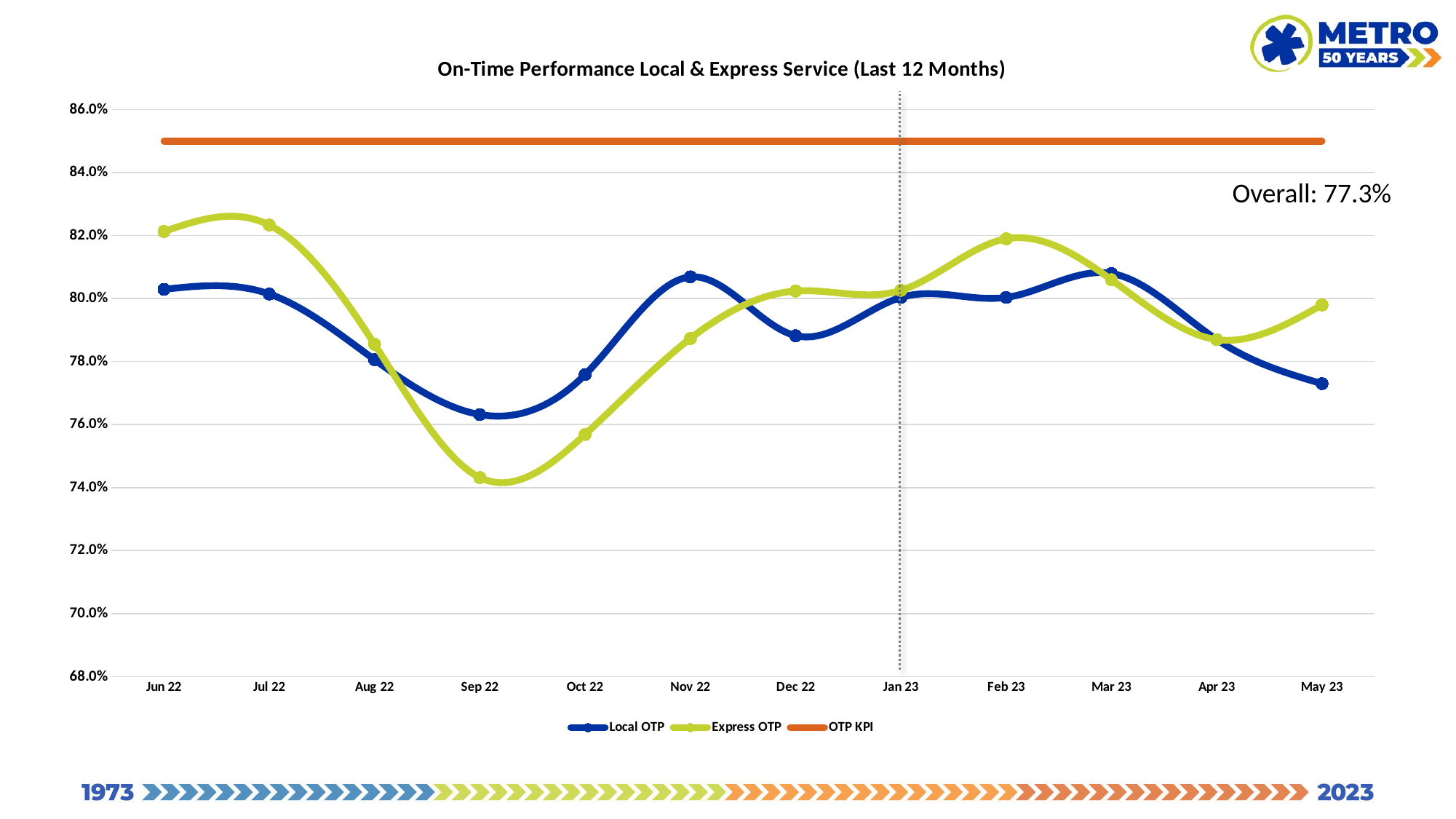
What kind of chart is shown on the slide? Line chart Does Express OTP rise or fall from Jun 22 to Sep 22? Fall How many series does the legend list? 3 How many months are plotted along the x axis? 12 In Sep 22, which is higher: Local OTP or Express OTP? Local OTP Is the Express OTP value for Sep 22 greater or less than 76.0%? less Is the Local OTP value for May 23 greater or less than 78.0%? less What is the title of the chart? On-Time Performance Local & Express Service (Last 12 Months) In which month is Local OTP at its lowest? Sep 22 In which month is Express OTP at its lowest? Sep 22 Is the Express OTP value for Jun 22 greater or less than 80.0%? greater What overall on-time performance value is printed on the chart? 77.3%